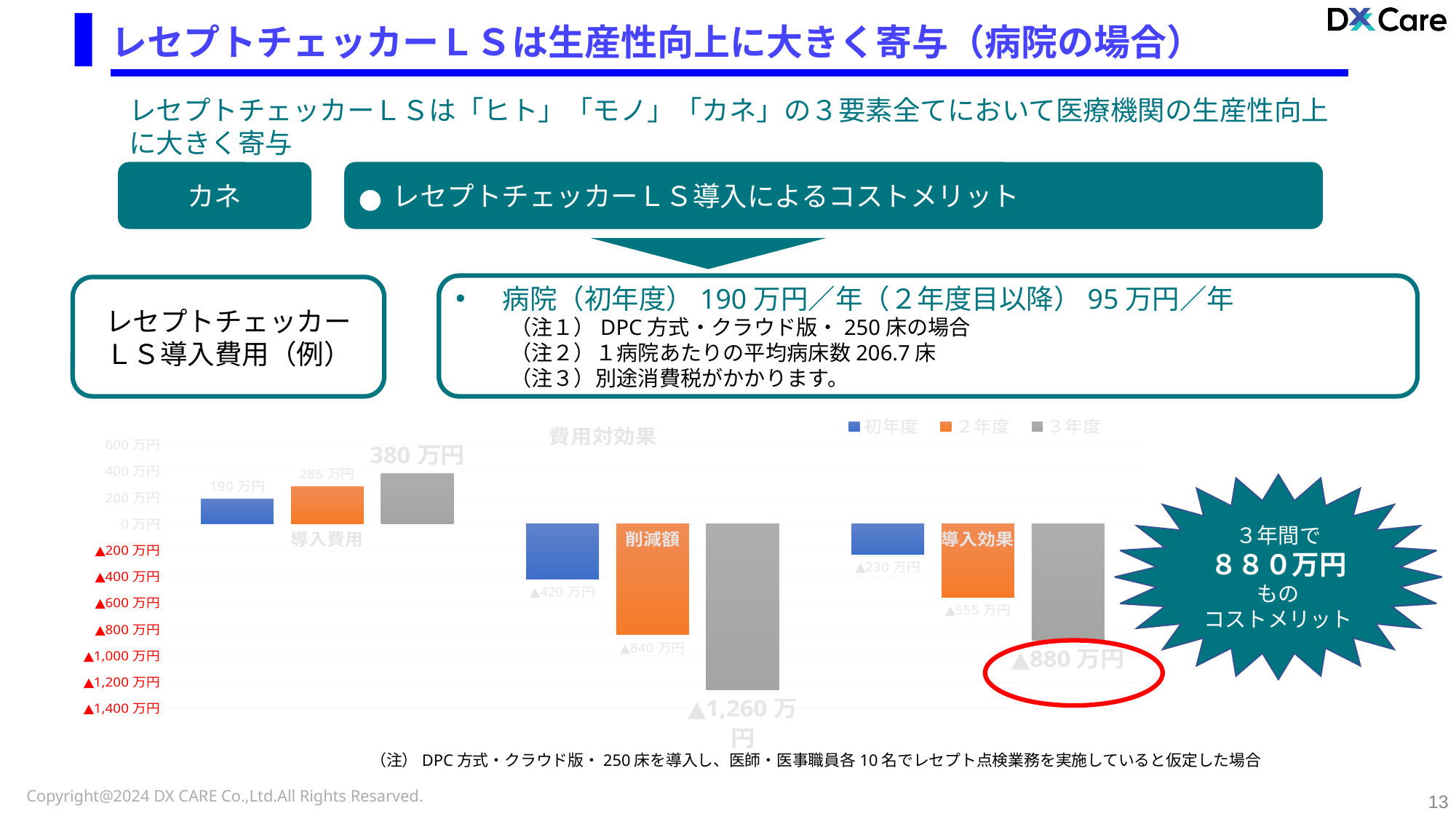
How many series does the chart legend list? 3 What is the 3年度 value for 削減額? ▲1,260 万円 What is the 2年度 value for 導入費用? 285 万円 What kind of chart is shown on the slide? bar chart Which series is shown in orange in the chart legend? 2年度 What is the 初年度 value for 導入費用? 190 万円 What is the 3年度 value for 導入効果? ▲880 万円 What is the 2年度 value for 削減額? ▲840 万円 How many categories are shown on the x axis of the chart? 3 What is the difference between the 3年度 and 初年度 values for 導入費用? 190 万円 What is the title of the chart on the slide? 費用対効果 What is the 3年度 value for 導入費用? 380 万円